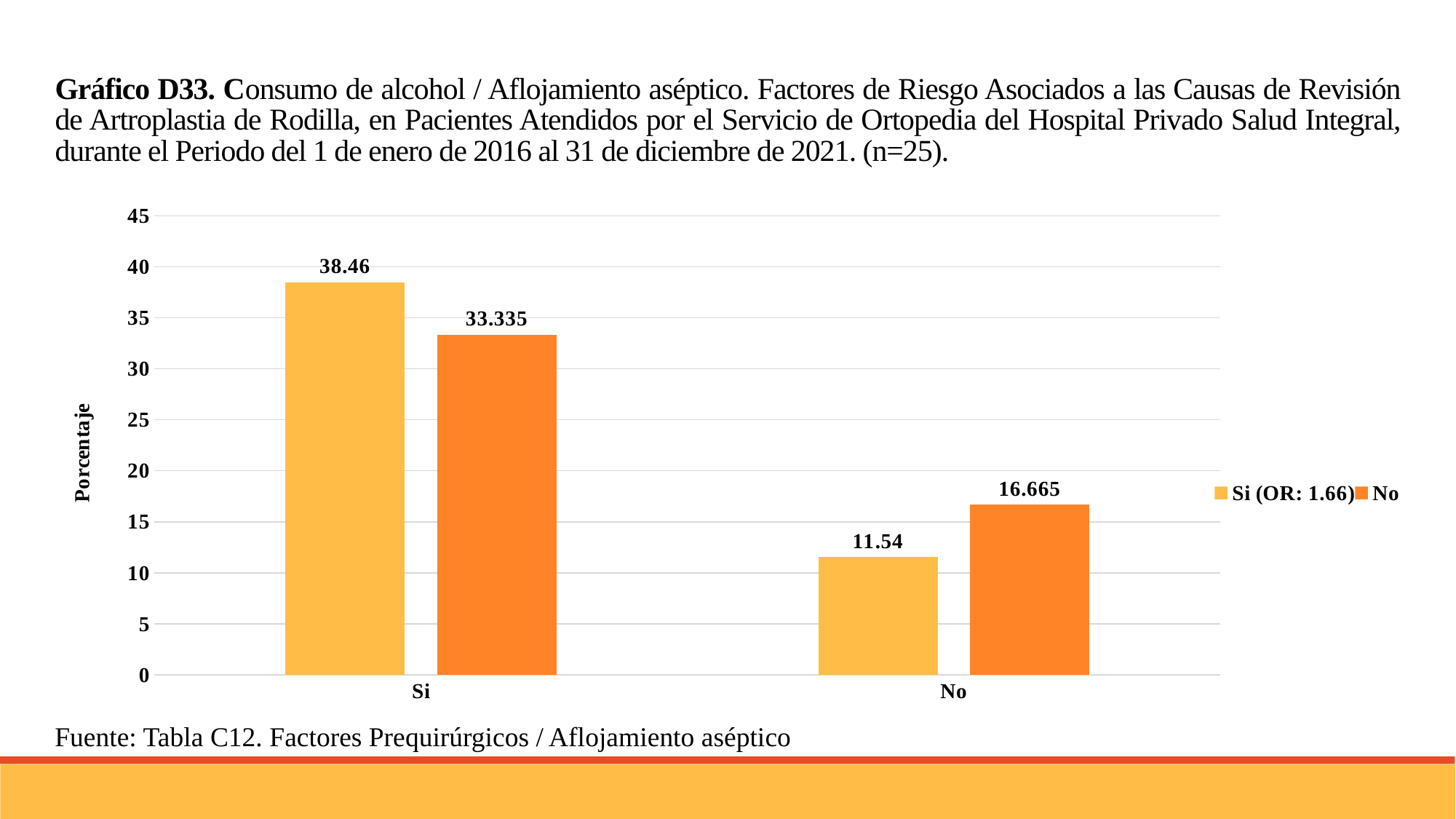
What is the difference between the 'Si (OR: 1.66)' and 'No' series values for the 'Si' category? 5.125 For the 'No' category, which series has the larger value: 'Si (OR: 1.66)' or 'No'? No What is the value of the 'No' series for the 'No' category? 16.665 What is the value of the 'Si (OR: 1.66)' series for the 'No' category? 11.54 How many categories are shown on the x axis? 2 What is the value of the 'Si (OR: 1.66)' series for the 'Si' category? 38.46 How many series does the legend list? 2 What kind of chart is shown on the slide? Bar chart What is the label of the y axis? Porcentaje Which bar has the lowest value on the chart? Si (OR: 1.66) for the No category (11.54) Which bar has the highest value on the chart? Si (OR: 1.66) for the Si category (38.46) What is the value of the 'No' series for the 'Si' category? 33.335